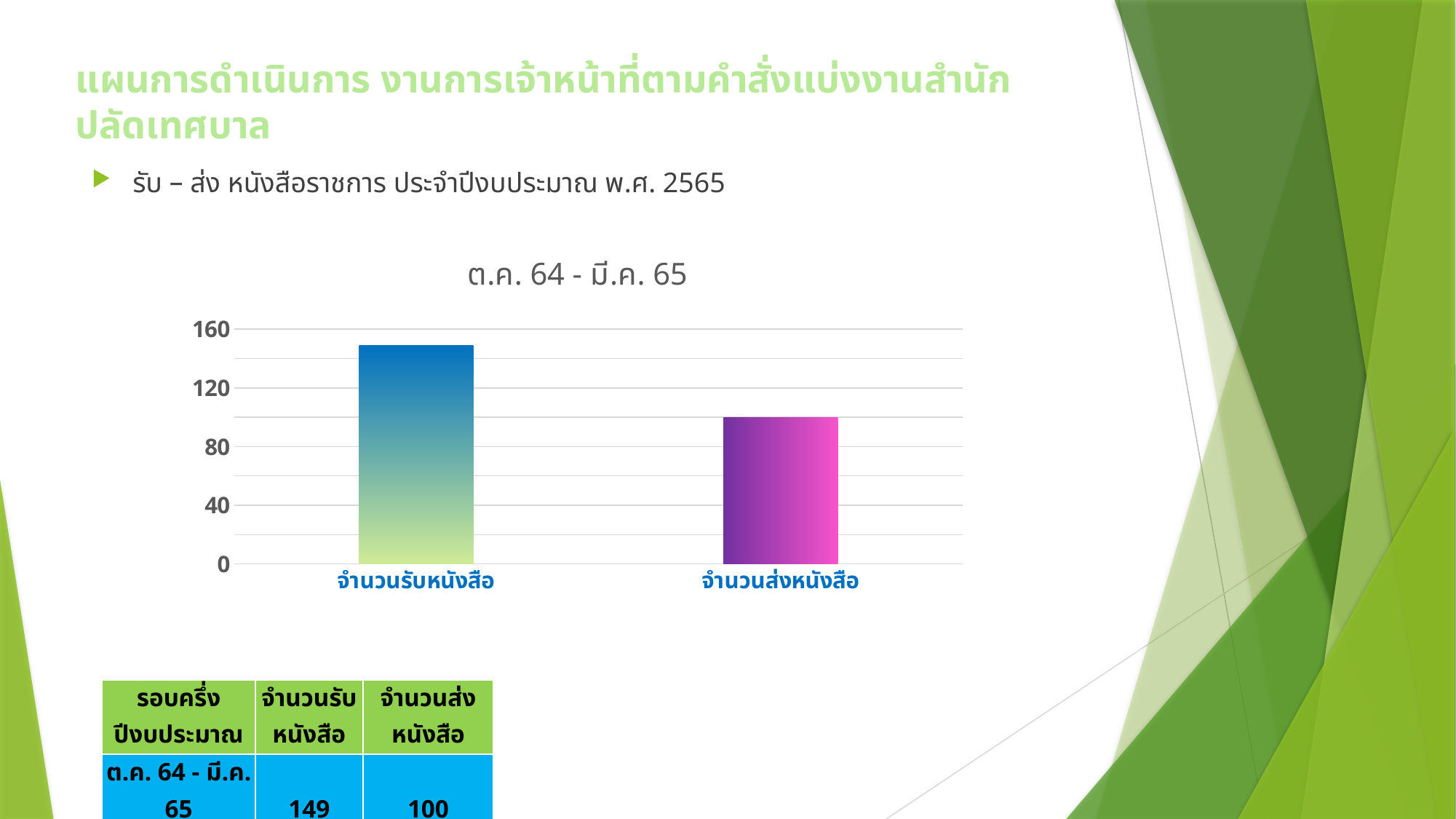
What is the value for จำนวนรับหนังสือ? 149 Is the value for จำนวนรับหนังสือ greater or less than 120? greater What is the title of the chart? ต.ค. 64 - มี.ค. 65 Which is larger, จำนวนรับหนังสือ or จำนวนส่งหนังสือ? จำนวนรับหนังสือ Which category has the lowest value? จำนวนส่งหนังสือ What is the highest value shown on the vertical axis? 160 What is the value for จำนวนส่งหนังสือ? 100 What type of chart is shown on the slide? bar chart Which category has the highest value? จำนวนรับหนังสือ What is the difference between จำนวนรับหนังสือ and จำนวนส่งหนังสือ? 49 How many bars (categories) does the chart show? 2 Is the value for จำนวนส่งหนังสือ greater or less than 120? less